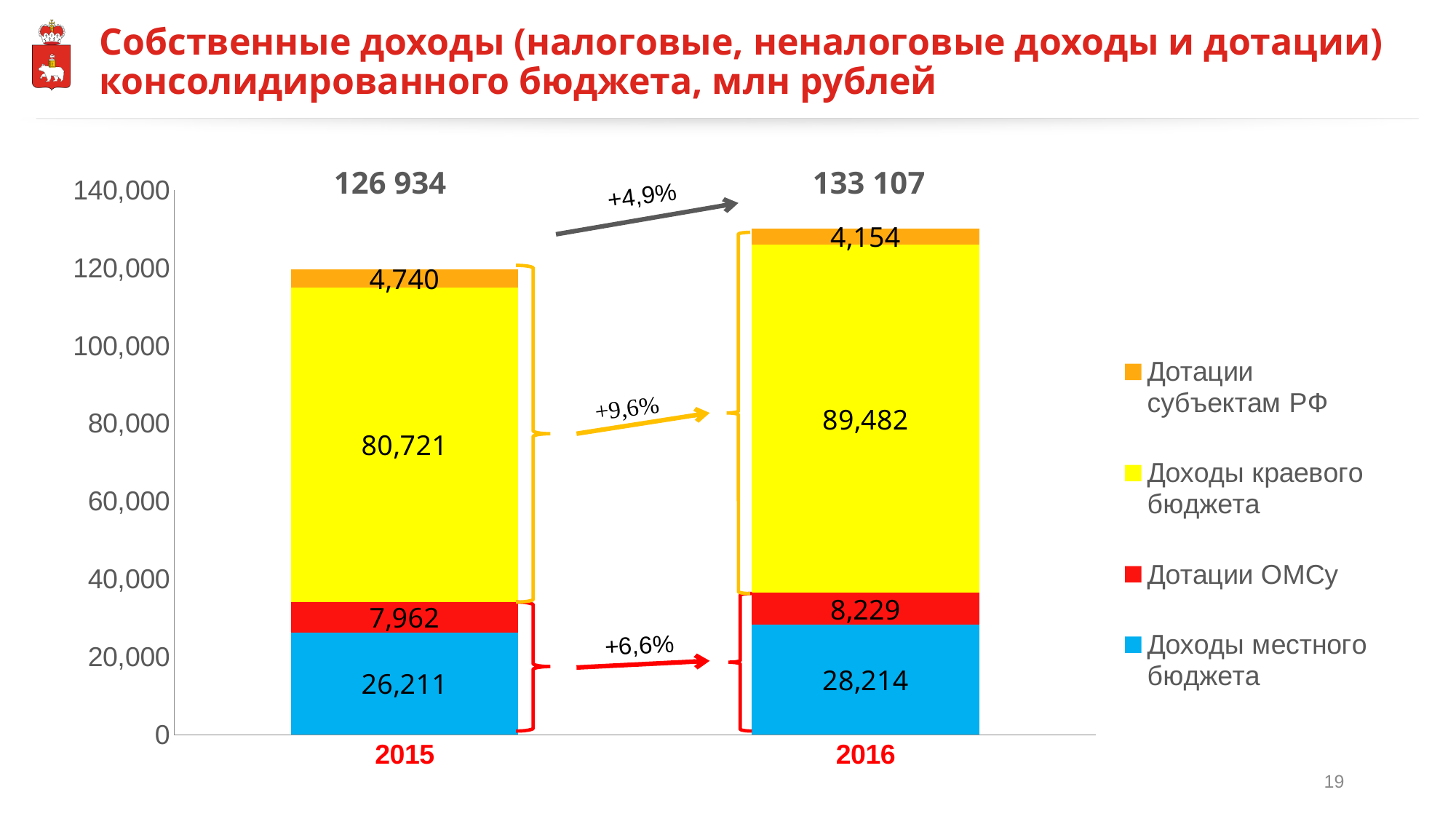
Which series has the largest segment in the 2016 bar? Доходы краевого бюджета Which series has the smallest segment in the 2015 bar? Дотации субъектам РФ What type of chart is shown on the slide? Stacked bar chart What is the value of Дотации ОМСу in 2015? 7,962 What total value is printed above the 2016 bar? 133 107 How many series does the legend list? 4 What is the value of Доходы местного бюджета in 2016? 28,214 By how much did Доходы краевого бюджета increase from 2015 to 2016? 8,761 Is the value of Дотации субъектам РФ larger in 2015 or in 2016? 2015 What is the value of Дотации субъектам РФ in 2016? 4,154 What percentage change is shown by the arrow between the two bars at the top of the chart? +4,9% What is the value of Доходы краевого бюджета in 2015? 80,721